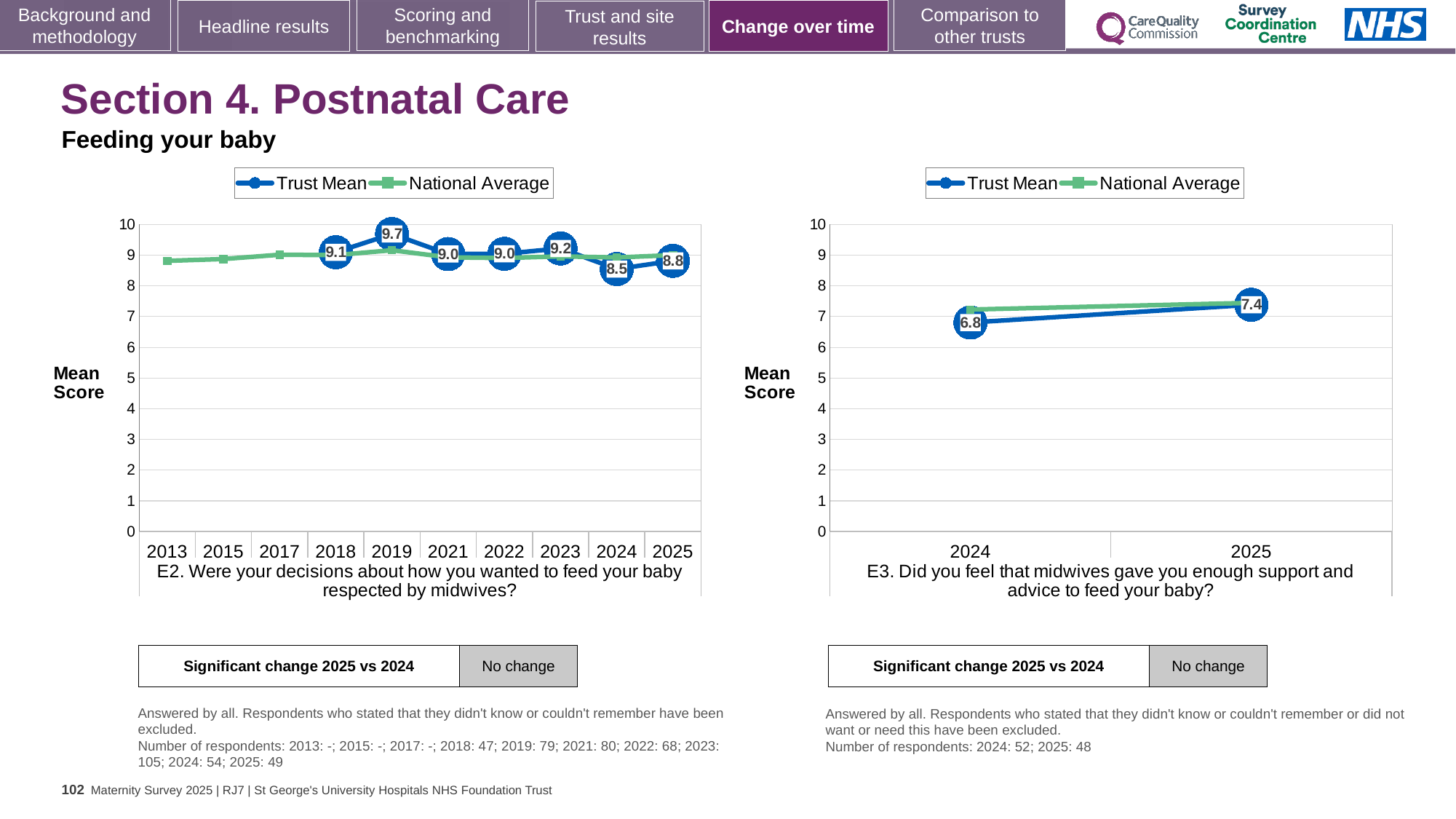
On the E3 chart (right), what is the Trust Mean for 2025? 7.4 On the E2 chart (left), which year has the lowest labelled Trust Mean? 2024 On the E3 chart (right), does the Trust Mean rise or fall from 2024 to 2025? rise On the E2 chart (left), which year has the highest Trust Mean? 2019 What kind of chart is the E3 chart (right)? line chart On the E2 chart (left), what is the difference between the Trust Mean in 2019 and in 2024? 1.2 On the E2 chart (left), what is the Trust Mean for 2019? 9.7 On the E2 chart (left), how many series does the legend list? 2 On the E2 chart (left), what is the Trust Mean for 2025? 8.8 On the E2 chart (left), what is the Trust Mean for 2024? 8.5 On the E3 chart (right), what is the Trust Mean for 2024? 6.8 On the E3 chart (right), is the National Average for 2024 greater or less than 6? greater